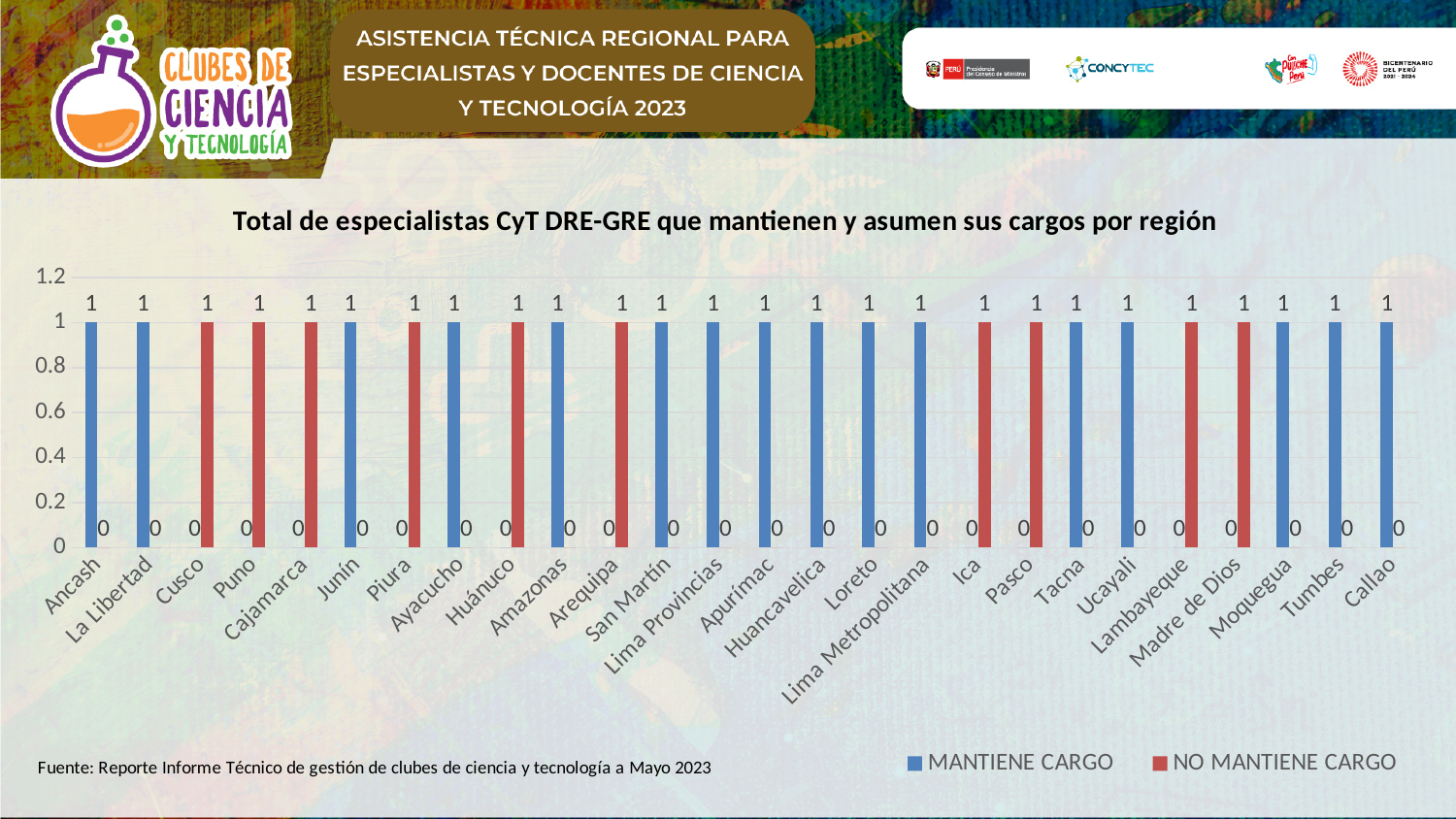
What is the value of NO MANTIENE CARGO for Callao? 0 Which is larger for Arequipa, MANTIENE CARGO or NO MANTIENE CARGO? NO MANTIENE CARGO How many regions are shown on the x axis of the chart? 26 What kind of chart is shown on the slide? Bar chart Which is larger for Tacna, MANTIENE CARGO or NO MANTIENE CARGO? MANTIENE CARGO What is the title of the chart? Total de especialistas CyT DRE-GRE que mantienen y asumen sus cargos por región What is the value of MANTIENE CARGO for Piura? 0 How many series does the legend list? 2 What is the value of MANTIENE CARGO for Ancash? 1 What is the value of NO MANTIENE CARGO for Cusco? 1 What is the value of MANTIENE CARGO for Lima Metropolitana? 1 What is the value of NO MANTIENE CARGO for Madre de Dios? 1